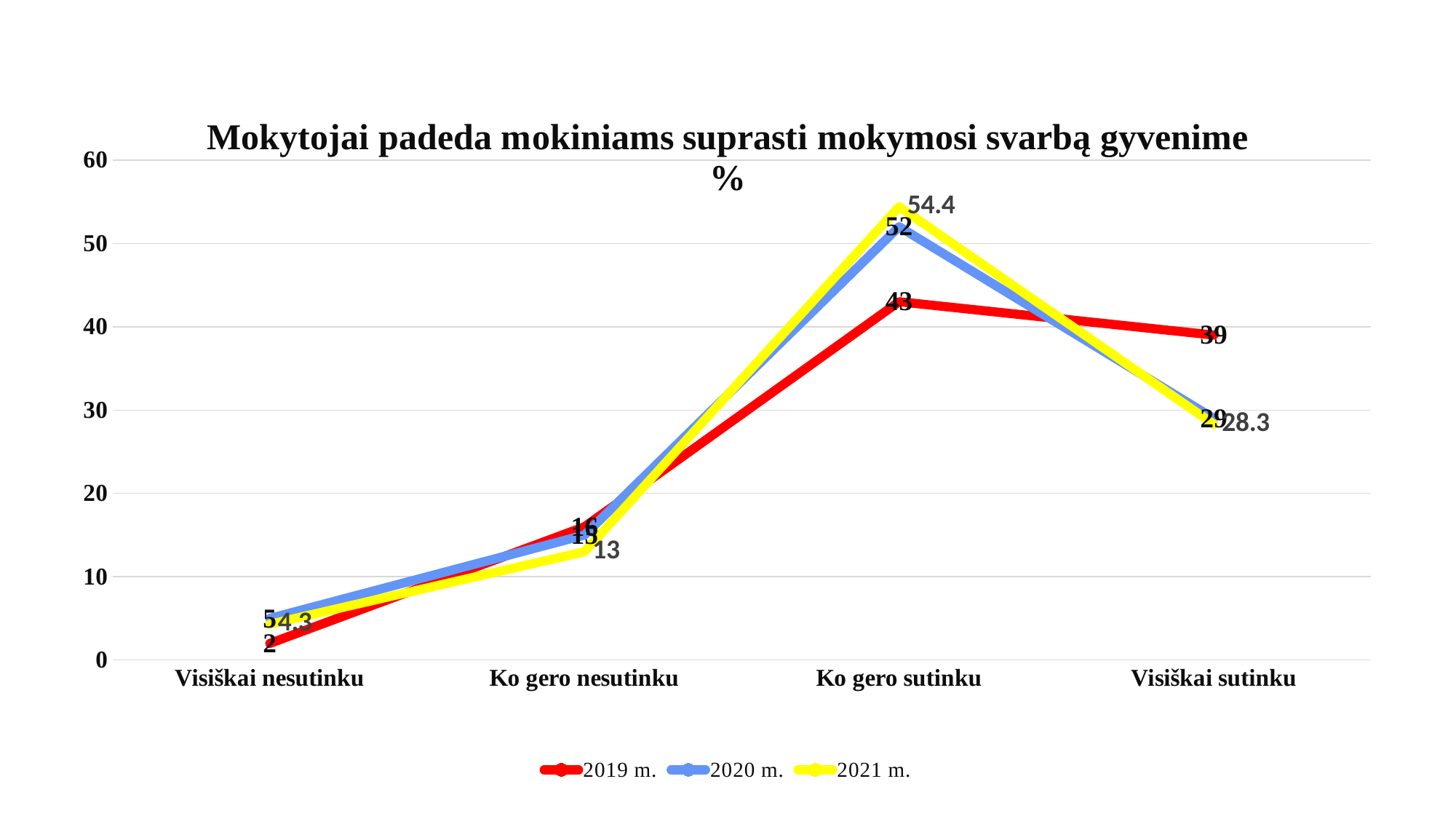
For the 2021 m. series, which category has the highest value? Ko gero sutinku What kind of chart is shown on the slide? Line chart How many series does the legend list? 3 What is the value for 2019 m. at Ko gero sutinku? 43 At Visiškai sutinku, which series has the larger value, 2019 m. or 2020 m.? 2019 m. What is the value for 2021 m. at Ko gero nesutinku? 13 What is the value for 2019 m. at Visiškai nesutinku? 2 What is the value for 2021 m. at Visiškai sutinku? 28.3 Is the value for 2020 m. at Ko gero sutinku greater or less than 50? greater What is the value for 2019 m. at Visiškai sutinku? 39 What is the difference between the 2021 m. and 2019 m. values at Ko gero sutinku? 11.4 What is the value for 2021 m. at Ko gero sutinku? 54.4